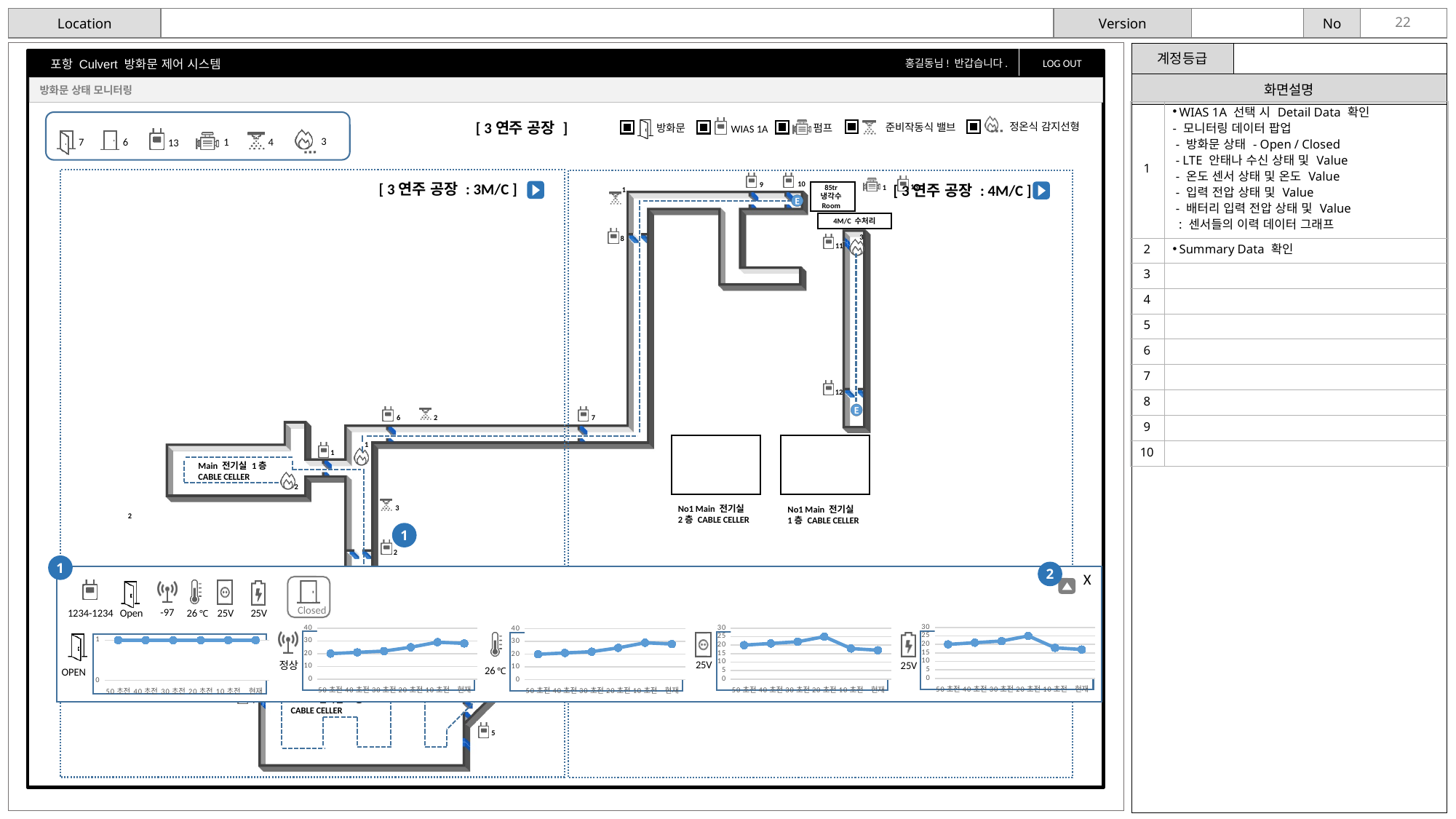
In the leftmost chart of the bottom detail panel (door status), what value does the line sit at for 현재? 1 How many time points are plotted along the x axis of the second chart from the left in the bottom detail panel (next to the antenna icon)? 6 In the leftmost chart of the bottom detail panel (door status), does the line rise, fall, or stay flat from 50 초전 to 현재? stays flat How many small line charts are shown in the detail panel at the bottom of the slide? 5 What kind of chart is the leftmost chart in the detail panel at the bottom of the slide (next to the OPEN door icon)? line chart In the third chart from the left in the bottom detail panel (temperature), is the value for 10 초전 greater or less than 20? greater In the rightmost chart of the bottom detail panel (battery voltage), is the value for 20 초전 greater or less than 15? greater In the fourth chart from the left in the bottom detail panel (input voltage), is the value for 현재 greater or less than 25? less What is the label of the last x-axis category in the charts of the bottom detail panel? 현재 In the second chart from the left in the bottom detail panel (antenna signal), do the values generally rise or fall from 50 초전 to 10 초전? rise